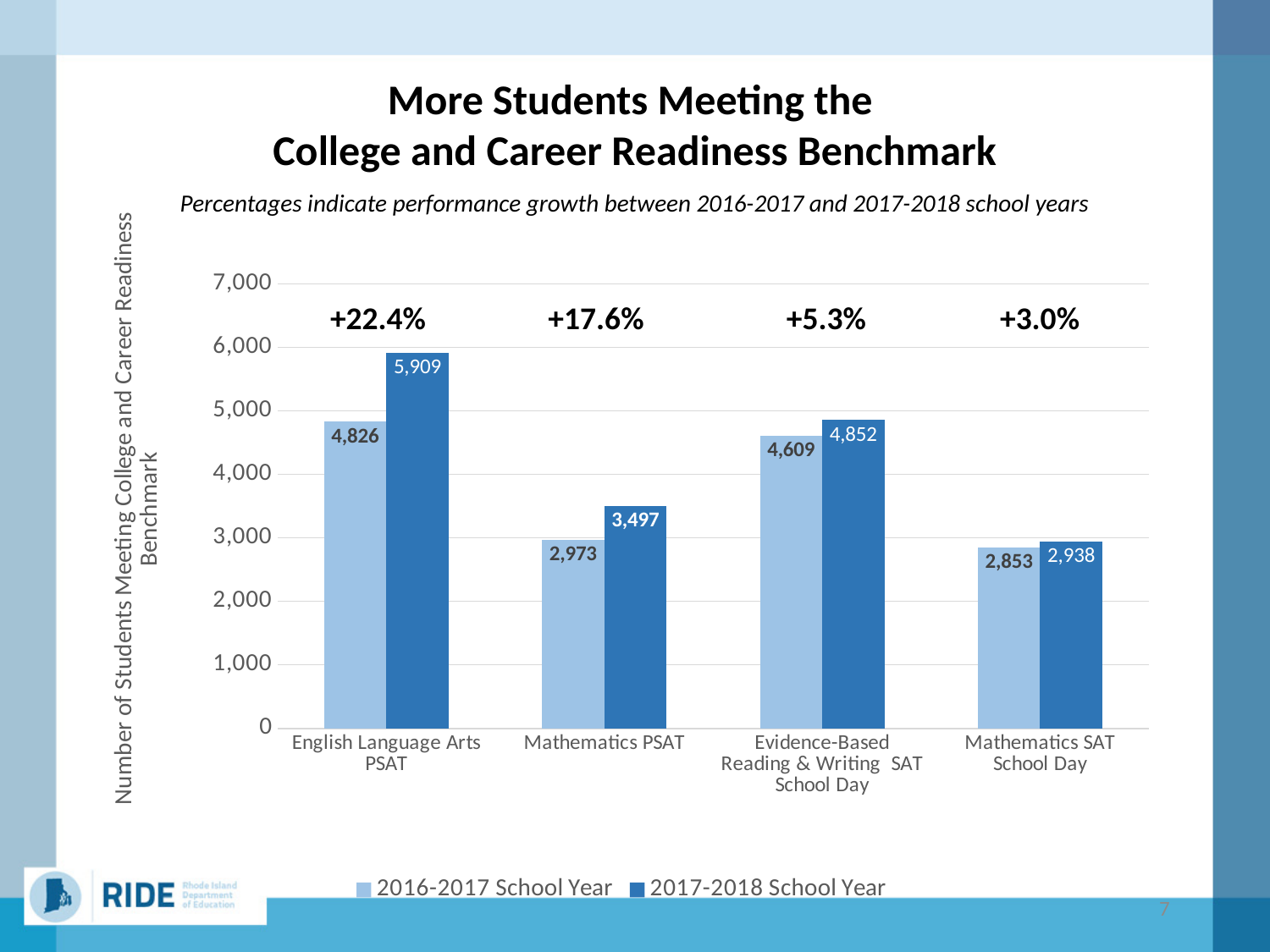
How many students met the benchmark on the English Language Arts PSAT in the 2017-2018 School Year? 5,909 What is the difference between the 2017-2018 and 2016-2017 values for Mathematics PSAT? 524 What is the value for Mathematics SAT School Day in the 2017-2018 School Year? 2,938 Which category has the lowest value in the 2016-2017 School Year? Mathematics SAT School Day Which is larger: the 2016-2017 value for Evidence-Based Reading & Writing SAT School Day or the 2016-2017 value for English Language Arts PSAT? English Language Arts PSAT Which category has the highest value in the 2017-2018 School Year? English Language Arts PSAT How many series does the legend list? 2 What percentage growth is shown above the Evidence-Based Reading & Writing SAT School Day bars? +5.3% What is the value for Mathematics PSAT in the 2016-2017 School Year? 2,973 What kind of chart is shown on the slide? Bar chart What is the title of the chart? More Students Meeting the College and Career Readiness Benchmark How many categories are shown on the x axis? 4